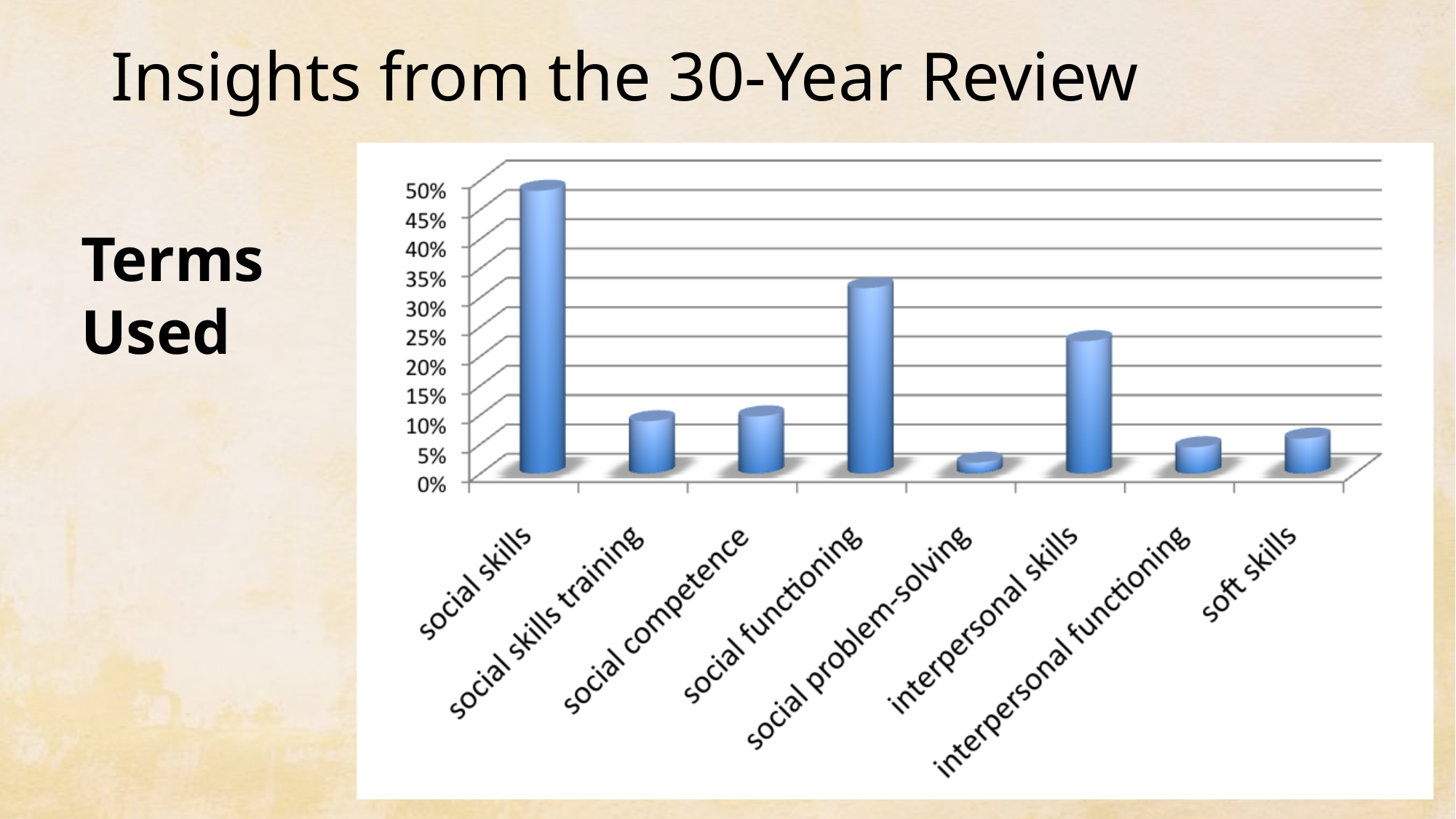
Is the value for interpersonal skills greater or less than 30%? less Is the value for social problem-solving greater or less than 5%? less Which is larger, the value for social skills or the value for social functioning? social skills What heading appears to the left of the chart on the slide? Terms Used Is the value for social skills training greater or less than 20%? less Which is larger, the value for interpersonal skills or the value for social competence? interpersonal skills What kind of chart is shown on the slide? bar chart Which term has the highest value on the chart? social skills How many terms (categories) are plotted on the chart? 8 Which term has the lowest value on the chart? social problem-solving